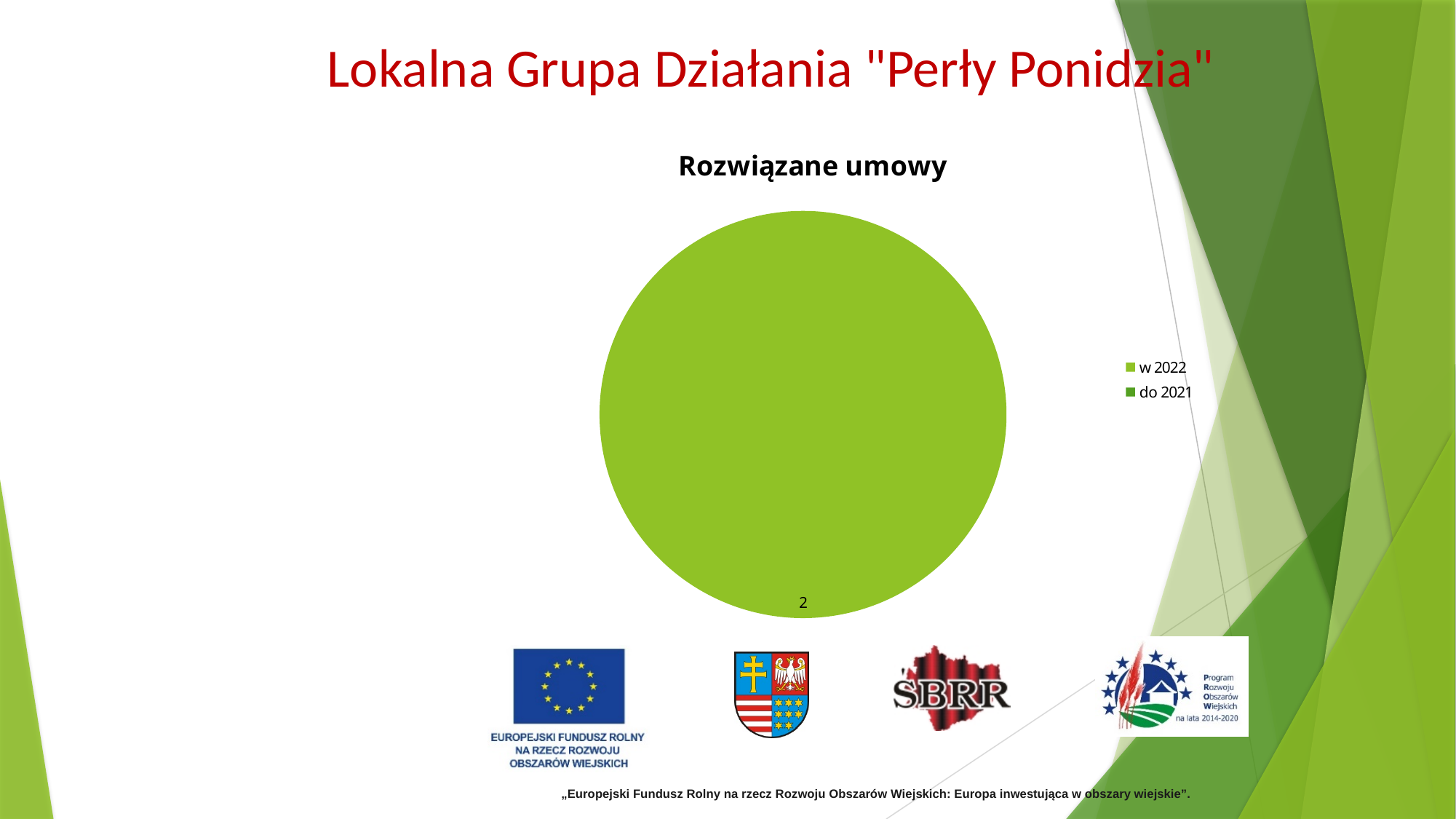
What is the title of the chart? Rozwiązane umowy How many entries does the chart's legend list? 2 Which legend entry does the colour of the visible pie slice correspond to? w 2022 What kind of chart is shown on the slide? pie chart What value is printed as the data label on the pie? 2 What is the value for "w 2022" in the chart? 2